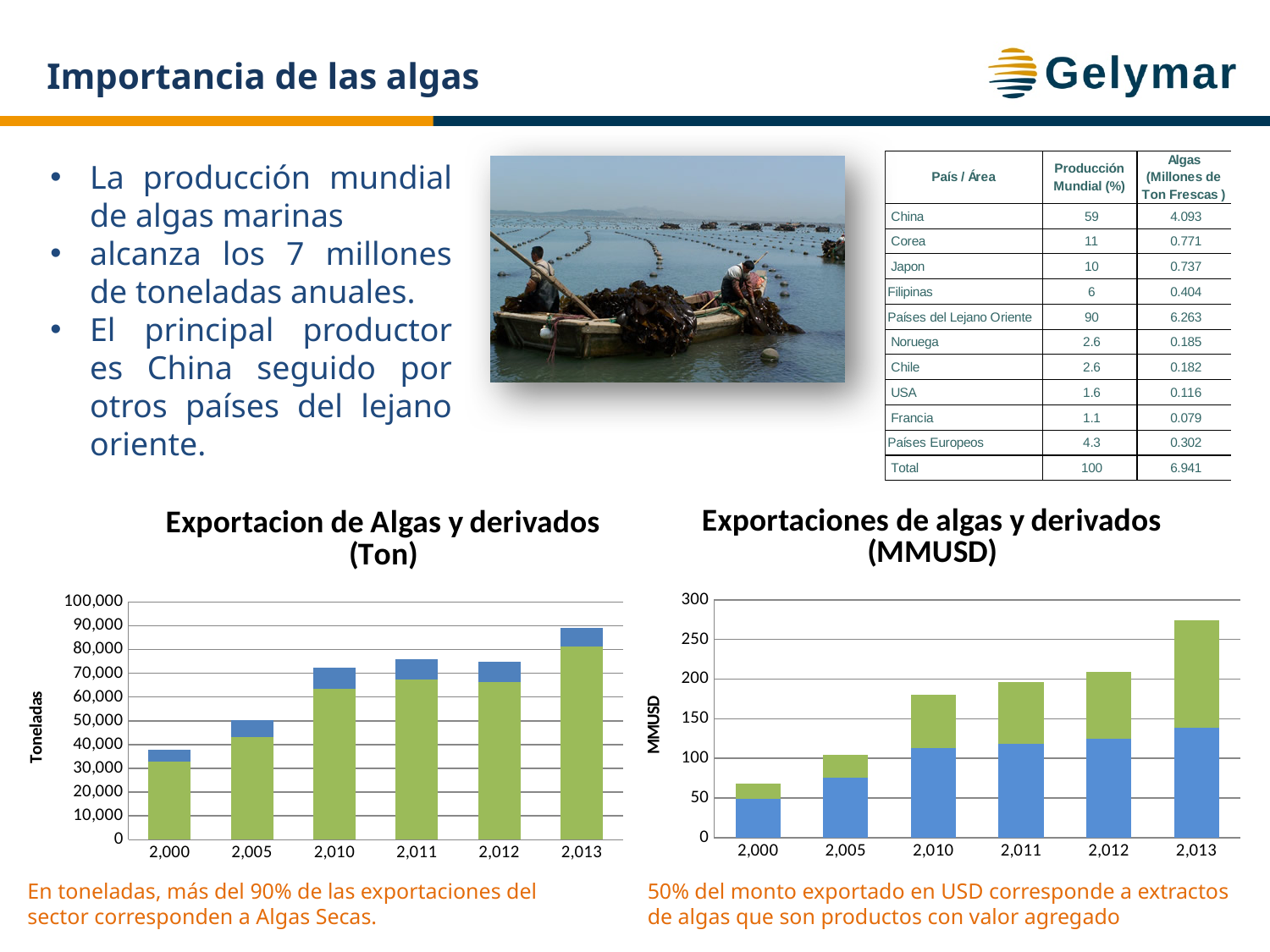
In the 'Exportacion de Algas y derivados (Ton)' chart, is the total for 2,000 greater or less than 50,000? less In the 'Exportacion de Algas y derivados (Ton)' chart, which year has the highest total bar? 2,013 How many years are shown on the x axis of the 'Exportaciones de algas y derivados (MMUSD)' chart? 6 In the 'Exportacion de Algas y derivados (Ton)' chart, is the total for 2,013 greater or less than 80,000? greater What kind of chart is the 'Exportacion de Algas y derivados (Ton)' chart? bar chart In the 'Exportaciones de algas y derivados (MMUSD)' chart, is the total for 2,000 greater or less than 100? less In the 'Exportaciones de algas y derivados (MMUSD)' chart, which year has the highest total bar? 2,013 In the 'Exportaciones de algas y derivados (MMUSD)' chart, which year has the lowest total bar? 2,000 In the 'Exportaciones de algas y derivados (MMUSD)' chart, which year has a larger total bar, 2,005 or 2,010? 2,010 In the 'Exportacion de Algas y derivados (Ton)' chart, which year has the lowest total bar? 2,000 What is the label on the y axis of the 'Exportacion de Algas y derivados (Ton)' chart? Toneladas